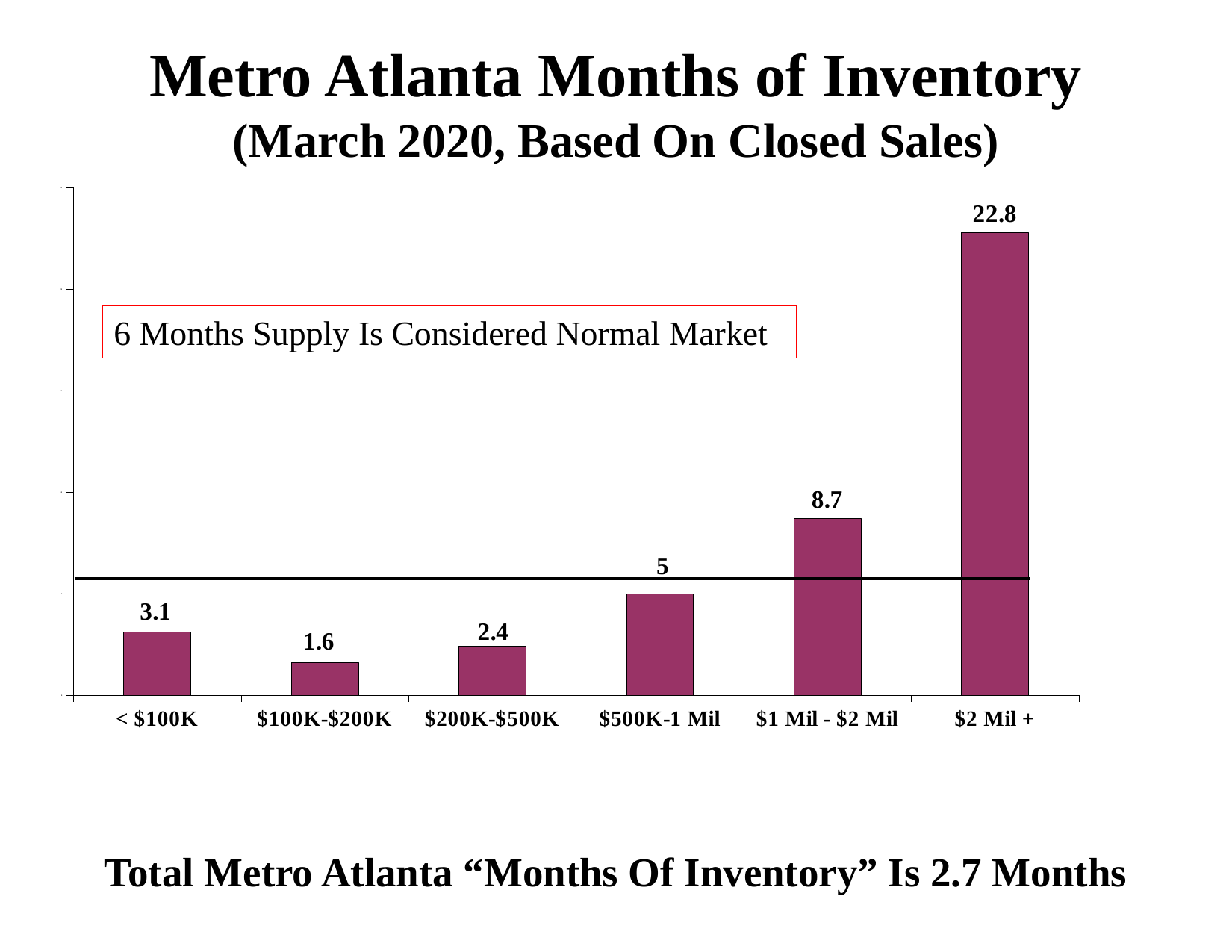
What is the months of inventory value for the $100K-$200K price range? 1.6 What kind of chart is shown on the slide? Bar chart What is the difference in months of inventory between the $2 Mil + and $1 Mil - $2 Mil price ranges? 14.1 Which has a larger months of inventory value, $200K-$500K or $500K-1 Mil? $500K-1 Mil How many price range categories are shown on the chart? 6 What is the months of inventory value for the $2 Mil + price range? 22.8 What is the months of inventory value for the < $100K price range? 3.1 Which price range has the highest months of inventory? $2 Mil + According to the text box on the chart, how many months of supply is considered a normal market? 6 Months Which price range has the lowest months of inventory? $100K-$200K What is the months of inventory value for the $500K-1 Mil price range? 5 What is the difference in months of inventory between the < $100K and $200K-$500K price ranges? 0.7